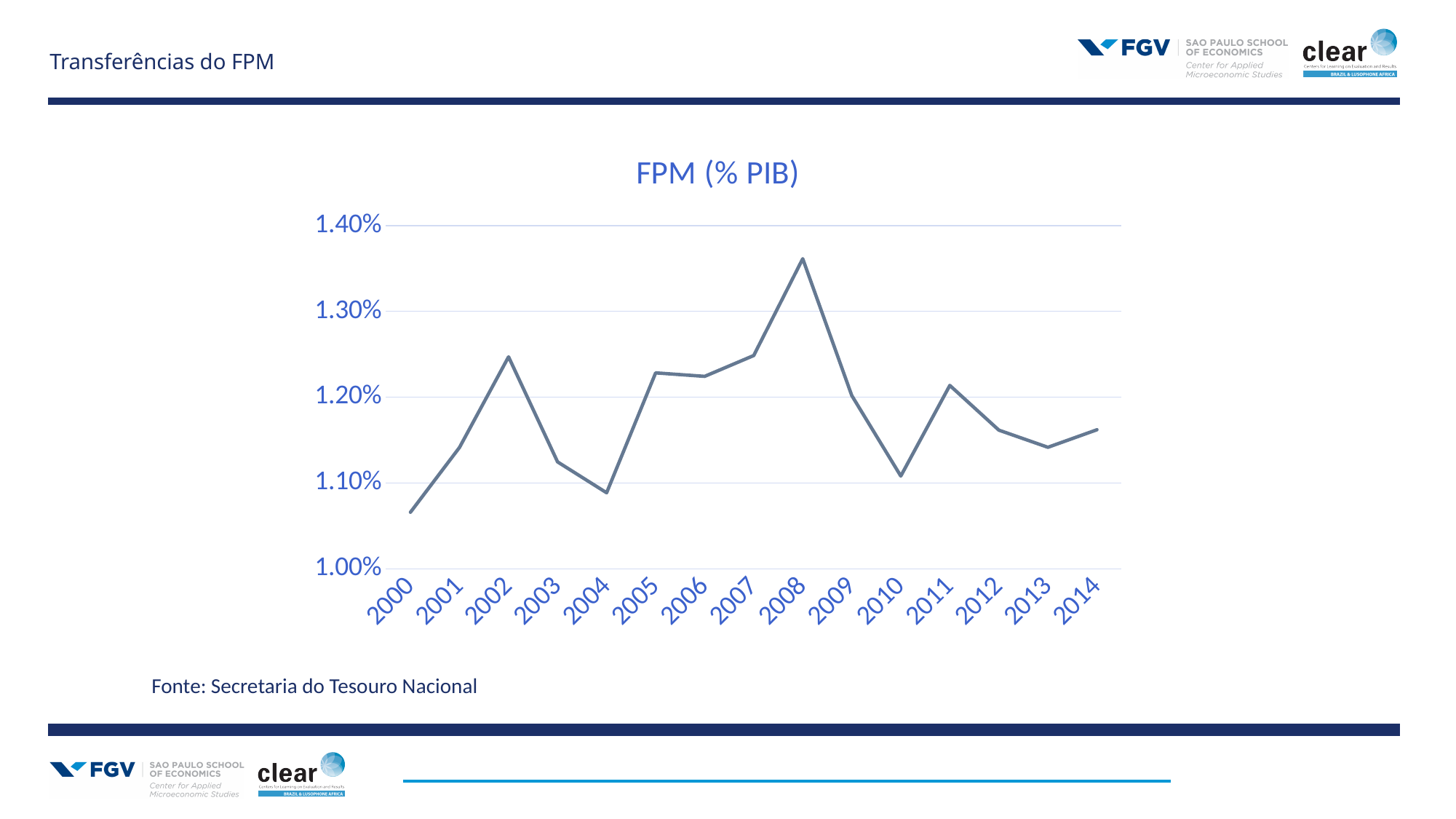
Is the value for 2013 greater or less than 1.20%? less Is the value for 2002 greater or less than 1.20%? greater In which year is FPM (% PIB) highest? 2008 Is the value for 2008 greater or less than 1.30%? greater In which year is FPM (% PIB) lowest? 2000 How many years are plotted on the x axis? 15 Which year has the larger value, 2008 or 2002? 2008 Does the value rise or fall from 2008 to 2010? fall What kind of chart is shown on the slide? line chart What is the title of the chart? FPM (% PIB) Which year has the larger value, 2000 or 2014? 2014